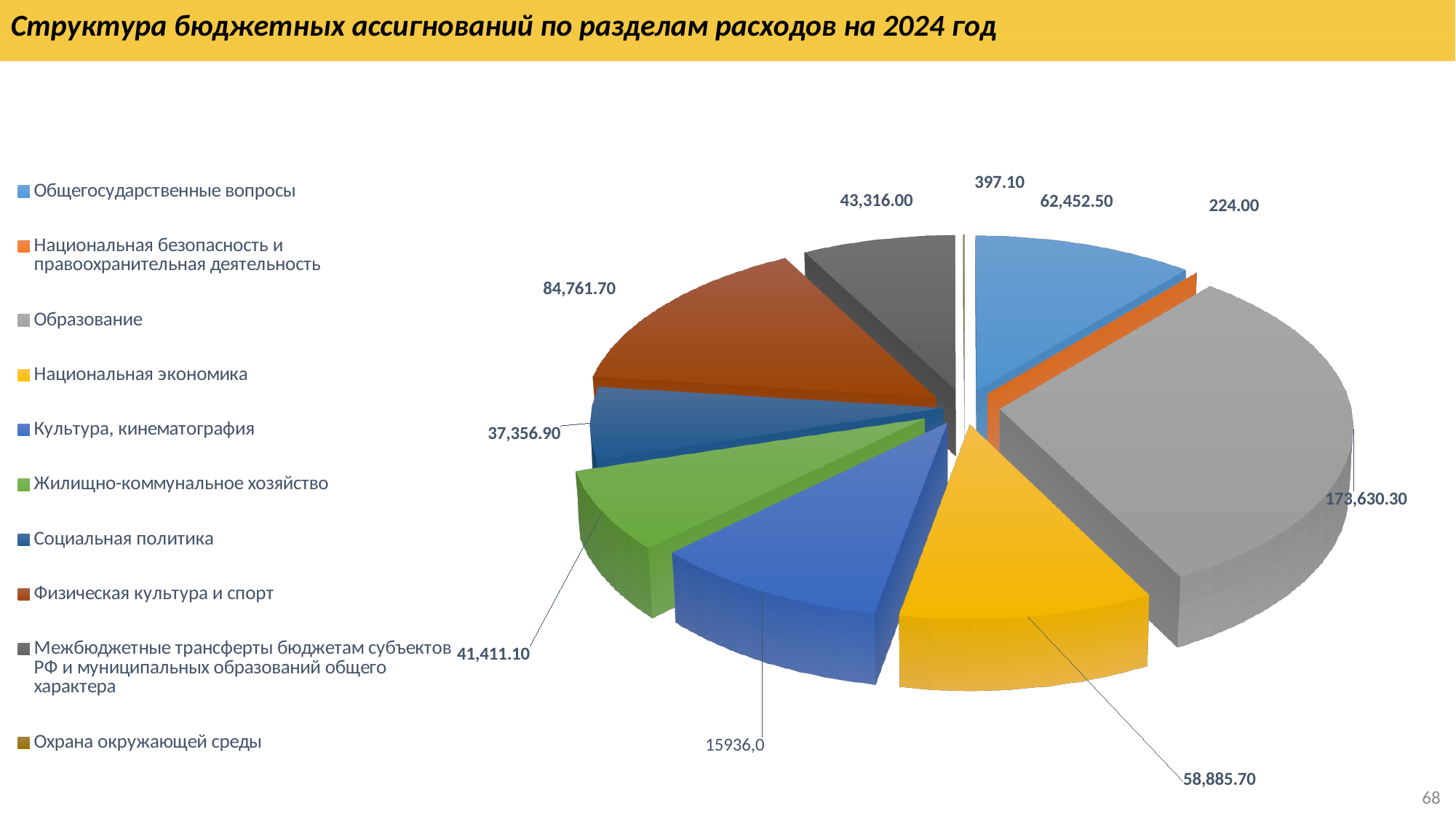
Which category has the largest value? Образование What is the difference between the values for Образование and Физическая культура и спорт? 88,868.60 What is the title of the slide? Структура бюджетных ассигнований по разделам расходов на 2024 год What is the value for Физическая культура и спорт? 84,761.70 What type of chart is shown on the slide? Pie chart What is the value for Национальная безопасность и правоохранительная деятельность? 224.00 How many categories does the legend list? 10 What is the value for Социальная политика? 37,356.90 What is the value for Образование? 173,630.30 Which category has the smallest value? Национальная безопасность и правоохранительная деятельность Which is larger: Жилищно-коммунальное хозяйство or Социальная политика? Жилищно-коммунальное хозяйство What is the difference between the values for Общегосударственные вопросы and Национальная экономика? 3,566.80